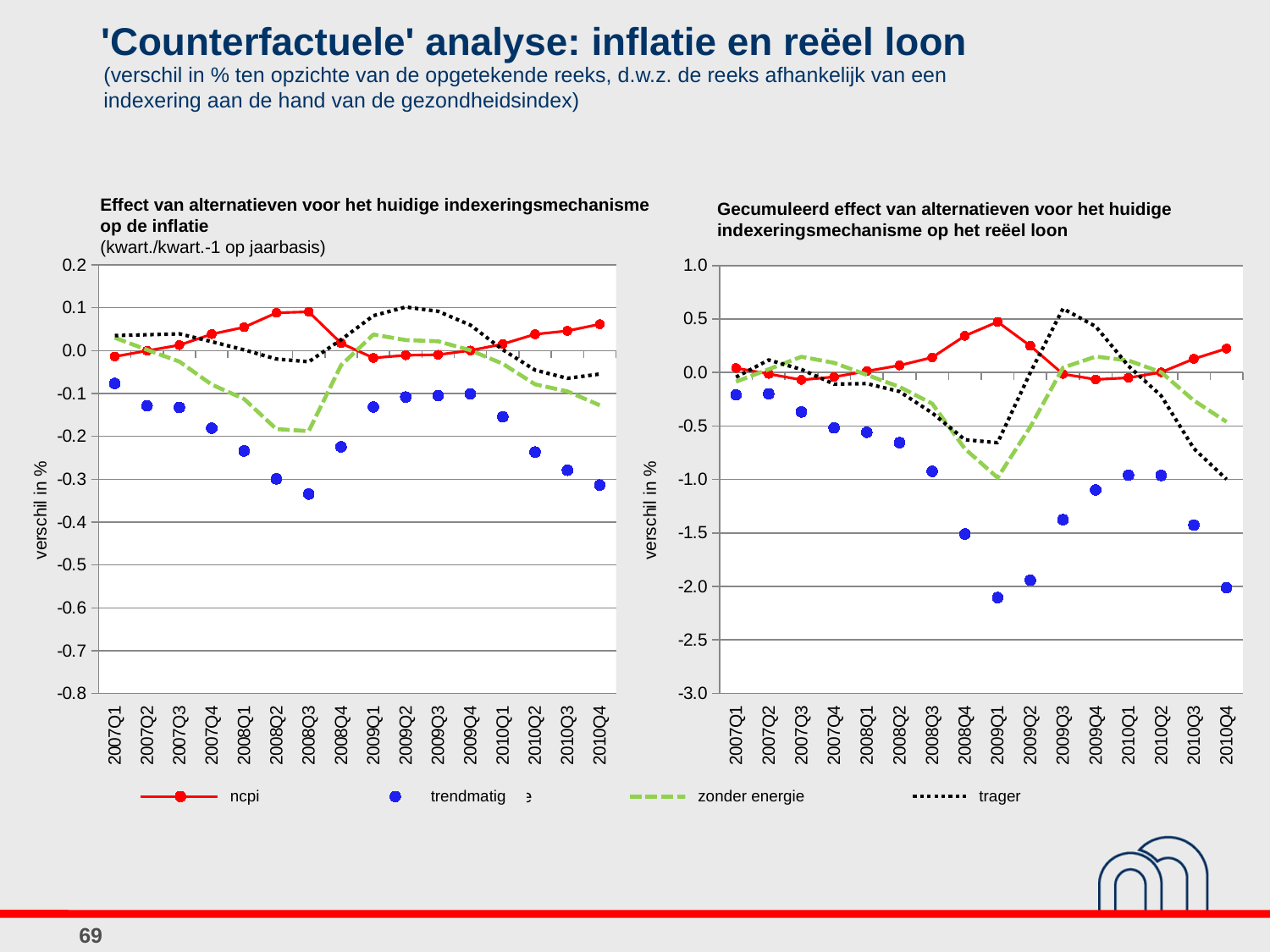
In the right chart on reëel loon, is the value of the trendmatig series at 2009Q1 greater or less than -1.5? less How many series does the shared legend below the charts list? 4 In the left chart on inflation, at which quarter does the trendmatig series reach its lowest value? 2008Q3 In the left chart on inflation, at 2008Q3, which series has the larger value: ncpi or trendmatig? ncpi What is the y-axis label on the left chart on inflation? verschil in % In the right chart on reëel loon, at 2009Q1, which series has the larger value: trager or trendmatig? trager What kind of chart is the left chart, 'Effect van alternatieven voor het huidige indexeringsmechanisme op de inflatie'? line chart In the right chart on reëel loon, is the value of the ncpi series at 2009Q1 greater or less than 0.0? greater In the left chart on inflation, is the value of the trendmatig series at 2008Q3 greater or less than -0.2? less In the right chart on reëel loon, does the trendmatig series rise or fall from 2007Q1 to 2009Q1? fall In the right chart on reëel loon, at which quarter does the ncpi series reach its highest value? 2009Q1 In the right chart, 'Gecumuleerd effect ... op het reëel loon', how many quarters are shown on the x axis? 16